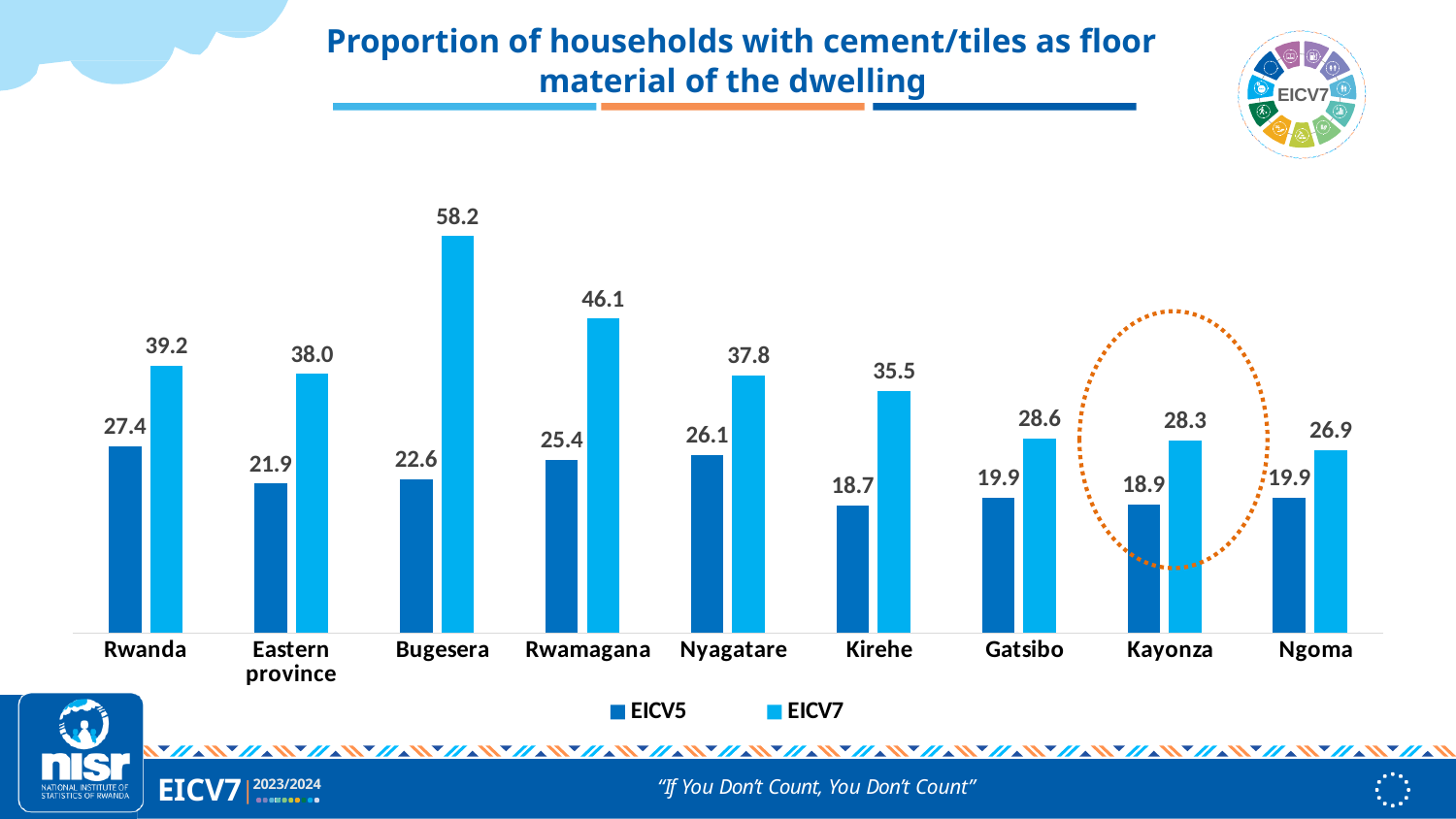
What is the EICV7 value for Kayonza? 28.3 How many categories are shown on the x axis? 9 What is the EICV7 value for Bugesera? 58.2 Which is larger, the EICV5 value for Rwamagana or the EICV5 value for Nyagatare? Nyagatare What is the EICV5 value for Kirehe? 18.7 Which category has the lowest EICV5 value? Kirehe What is the difference between the EICV7 and EICV5 values for Rwanda? 11.8 Which category has the highest EICV7 value? Bugesera What is the difference between the EICV7 values for Bugesera and Rwamagana? 12.1 Which category has the lowest EICV7 value? Ngoma How many series does the legend list? 2 What kind of chart is shown on the slide? Bar chart